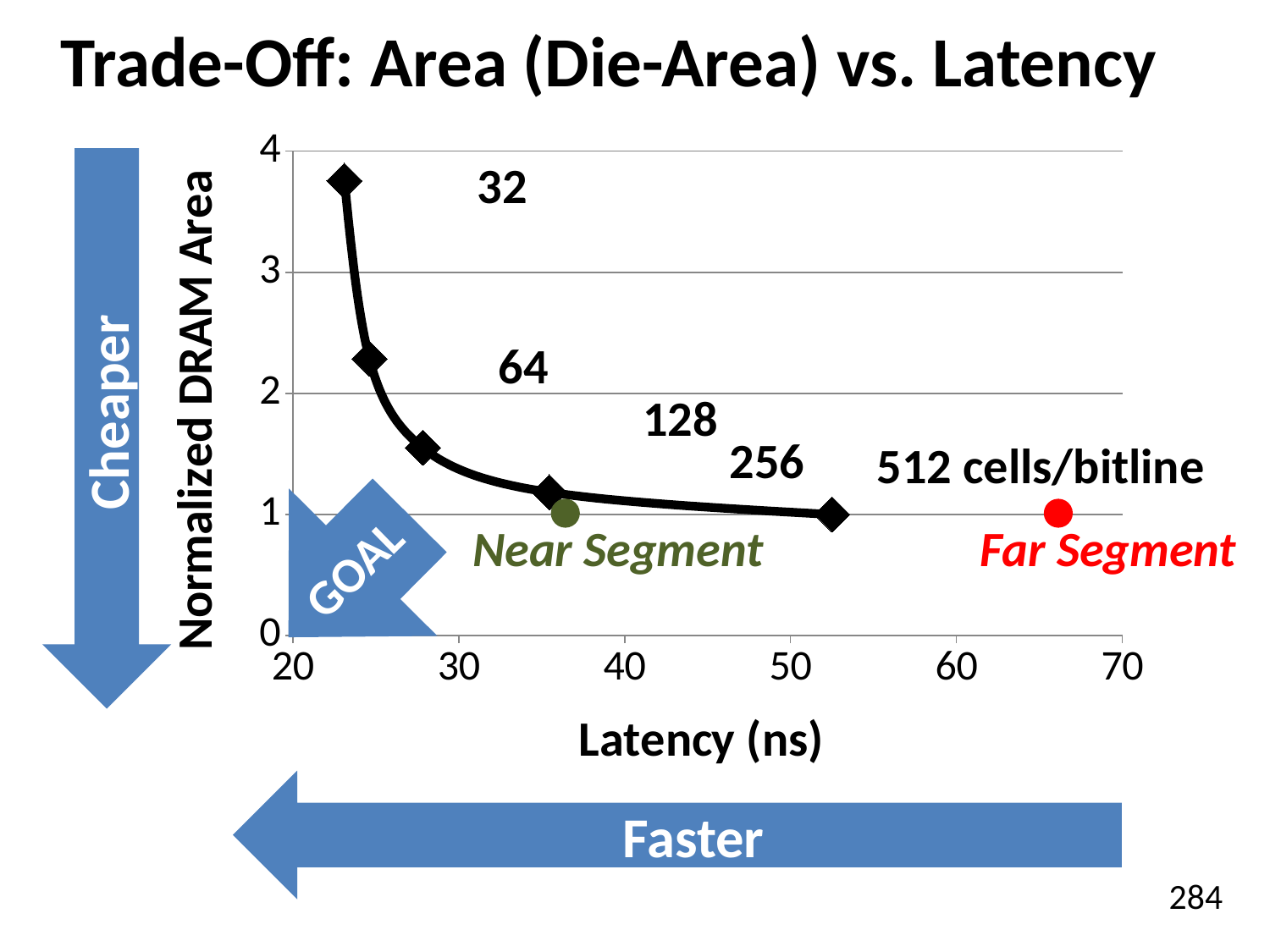
Which cells/bitline configuration has the lowest normalized DRAM area? 512 What is the title of the chart on the slide? Trade-Off: Area (Die-Area) vs. Latency Is the latency of the Far Segment point greater or less than 60 ns? greater Which cells/bitline configuration has the highest normalized DRAM area? 32 Is the normalized DRAM area for 64 cells/bitline greater or less than 2? greater How many black diamond data points are plotted on the curve? 5 What is the label of the x axis? Latency (ns) As latency increases along the x axis, does the normalized DRAM area rise or fall? fall Is the latency for 512 cells/bitline greater or less than 50 ns? greater Which has a larger normalized DRAM area, 64 cells/bitline or 128 cells/bitline? 64 cells/bitline Which cells/bitline configuration has the lowest latency? 32